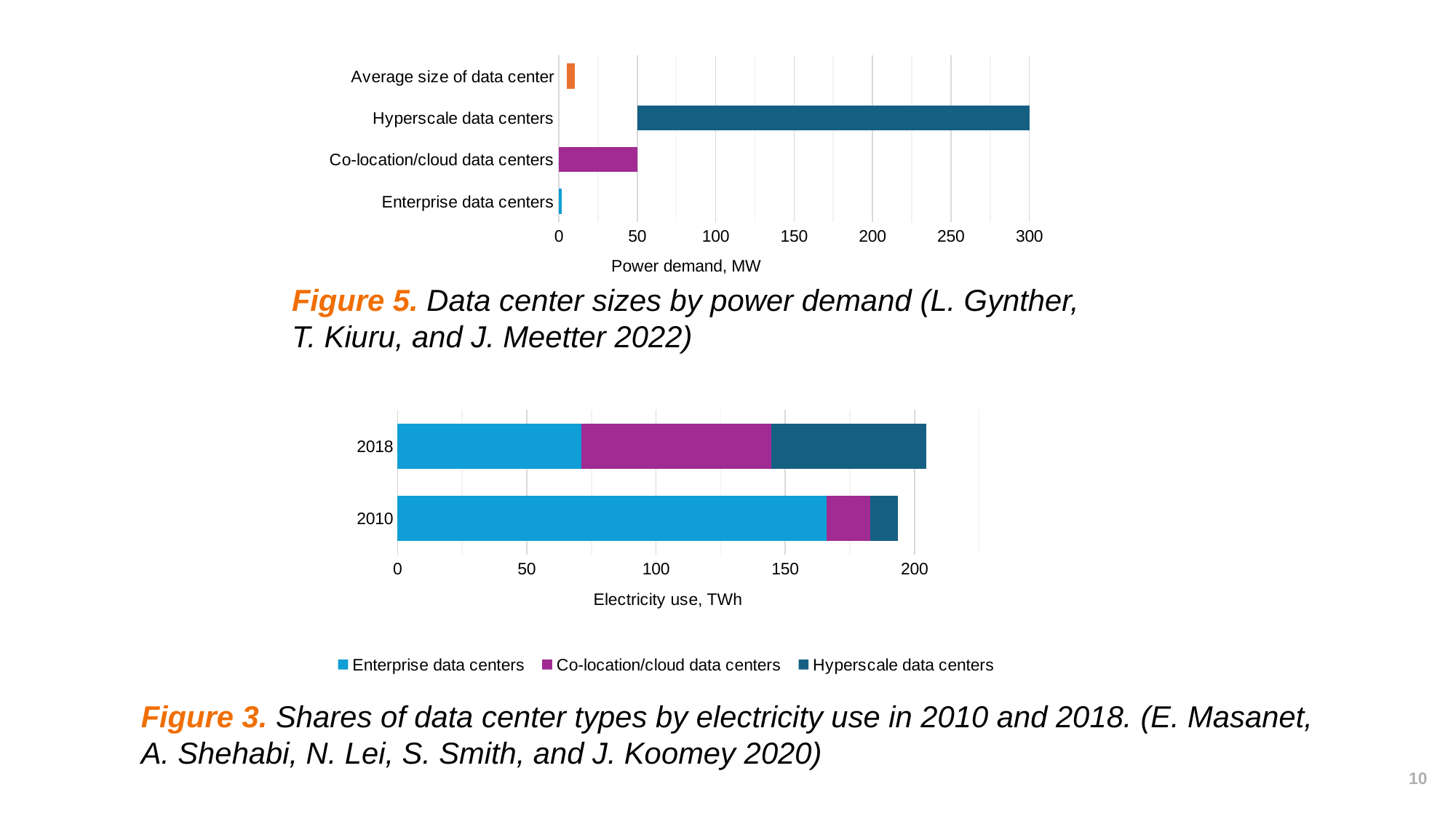
In Figure 3 (the bottom chart), is the Enterprise data centers segment for 2010 greater or less than 150 TWh? greater What kind of chart is Figure 5 (the top chart)? bar chart In Figure 5 (the top chart), which is larger: the power demand for Co-location/cloud data centers or for Average size of data center? Co-location/cloud data centers In Figure 5 (the top chart), which category has the highest power demand? Hyperscale data centers How many series does the legend of Figure 3 (the bottom chart) list? 3 How many categories are shown in Figure 5 (the top chart)? 4 In Figure 5 (the top chart), is the upper end of the Hyperscale data centers bar greater or less than 250 MW? greater In Figure 5 (the top chart), is the power demand for Co-location/cloud data centers greater or less than 100 MW? less What is the x-axis label of Figure 5 (the top chart)? Power demand, MW In Figure 5 (the top chart), which category has the lowest power demand? Enterprise data centers In Figure 3 (the bottom chart), does the Enterprise data centers electricity use rise or fall from 2010 to 2018? fall How many years are shown in Figure 3 (the bottom chart)? 2